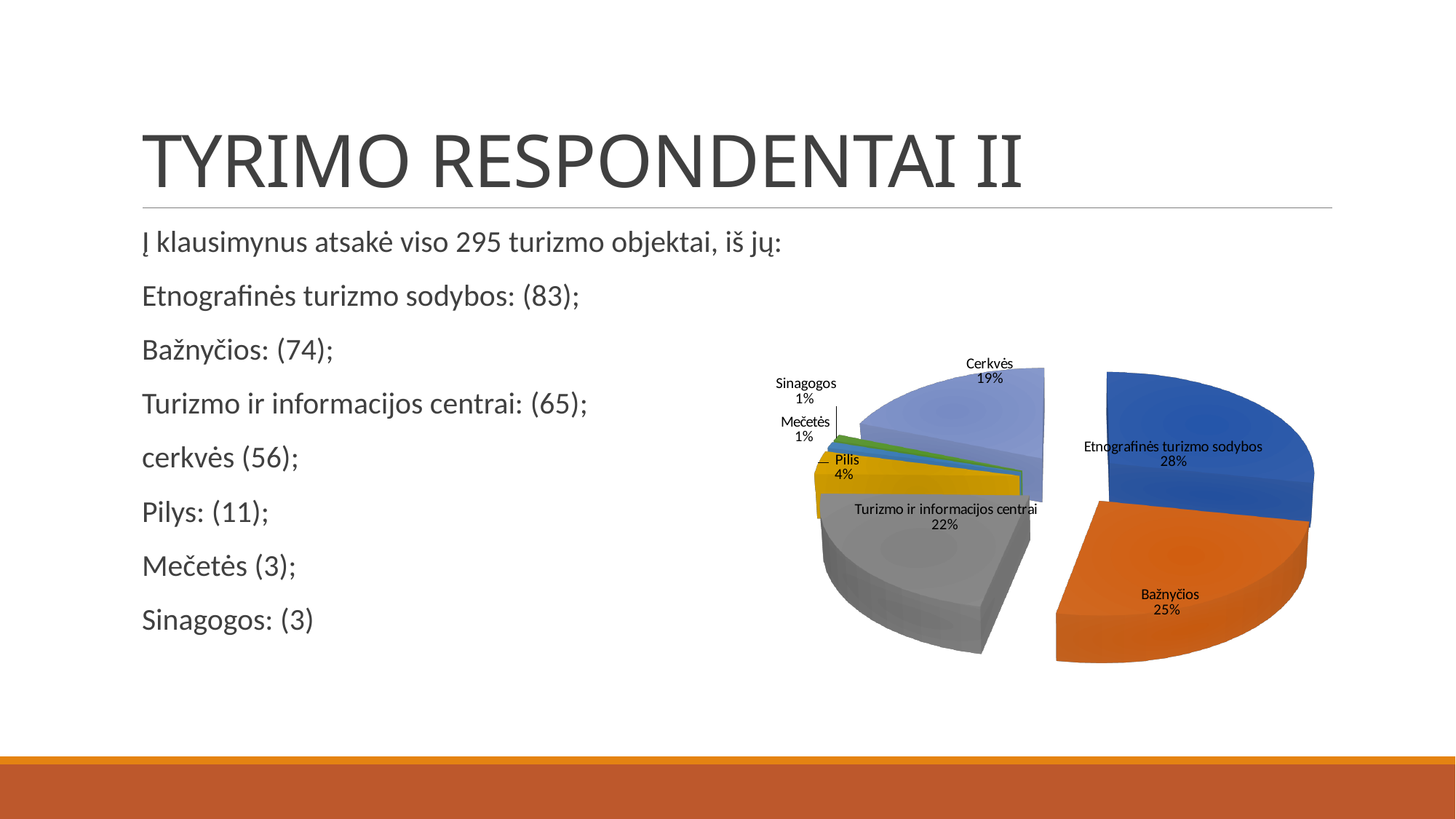
What percentage share does the Etnografinės turizmo sodybos slice have? 28% Which is larger, the share for Cerkvės or the share for Turizmo ir informacijos centrai? Turizmo ir informacijos centrai What percentage is shown for Bažnyčios? 25% What is the difference in percentage points between Pilis and Mečetės? 3 What type of chart is shown on the slide? pie chart What percentage is shown for Cerkvės? 19% Which category has the largest share of the pie? Etnografinės turizmo sodybos What percentage is shown for Turizmo ir informacijos centrai? 22% What is the difference in percentage points between Etnografinės turizmo sodybos and Bažnyčios? 3 How many slices does the pie chart have? 7 What colour is the Bažnyčios slice? orange What percentage is shown for Pilis? 4%